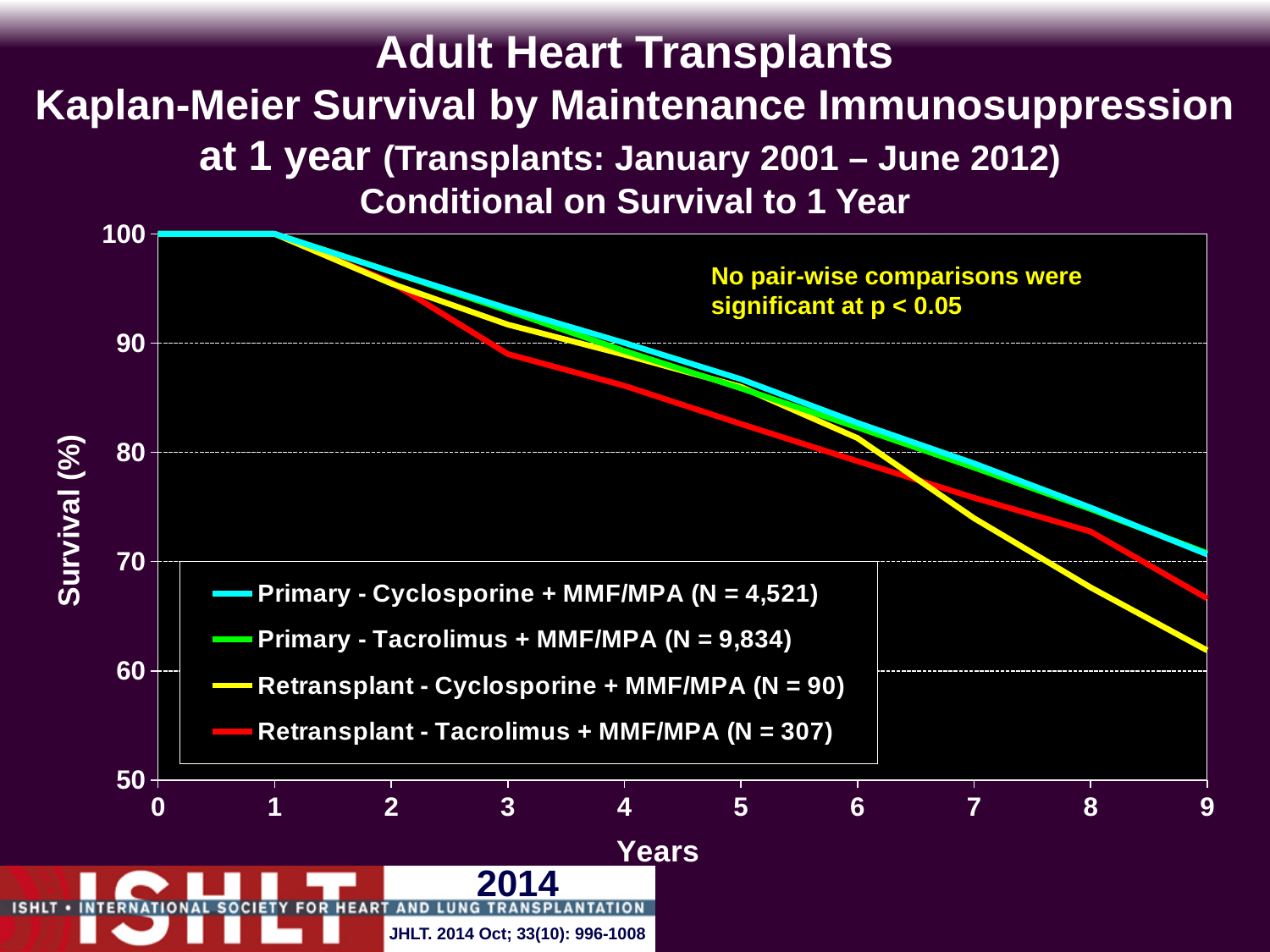
Is the survival value for Retransplant - Tacrolimus + MMF/MPA at year 8 greater or less than 70? greater What kind of chart is shown on the slide? line chart Is the survival value for Retransplant - Cyclosporine + MMF/MPA at year 9 greater or less than 70? less According to the legend, what is N for the Primary - Tacrolimus + MMF/MPA group? 9,834 Is the survival value for Retransplant - Tacrolimus + MMF/MPA at year 5 greater or less than 90? less How many series does the legend list? 4 Do the survival curves rise or fall as the years increase? fall What does the annotation on the chart say about pair-wise comparisons? No pair-wise comparisons were significant at p < 0.05 What survival percentage do all four series show at year 1? 100 At year 9, which is higher: Primary - Cyclosporine + MMF/MPA or Retransplant - Tacrolimus + MMF/MPA? Primary - Cyclosporine + MMF/MPA Which series has the lowest survival at year 9? Retransplant - Cyclosporine + MMF/MPA